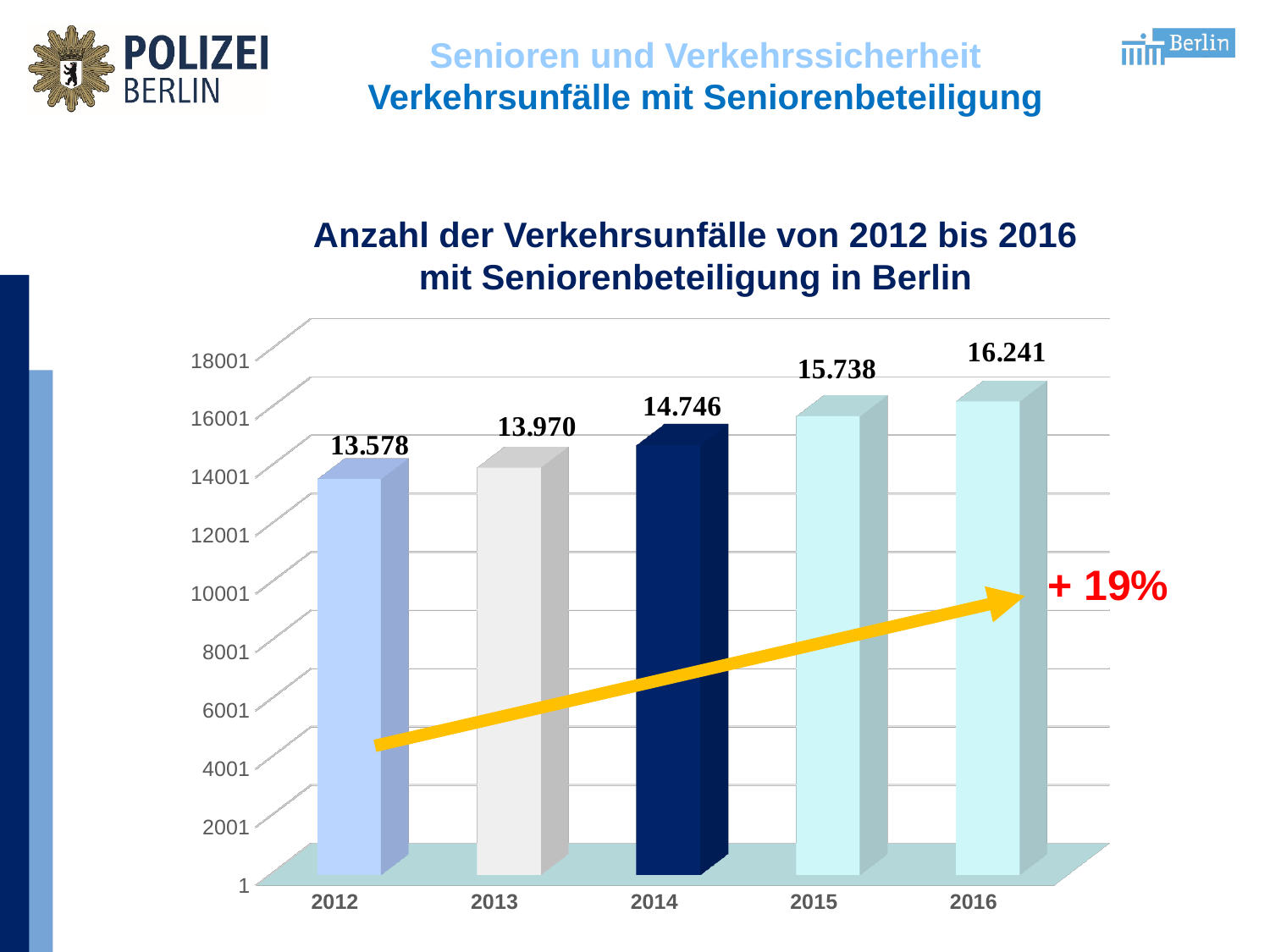
Do the values rise or fall from 2012 to 2016? rise What is the value for 2012? 13.578 Is the value for 2013 greater or less than 12001? greater What is the value for 2016? 16.241 Which year has the lowest value? 2012 What is the value for 2014? 14.746 Which is larger, the value for 2013 or the value for 2015? 2015 What kind of chart is shown? bar chart How many years are shown on the x axis? 5 What is the difference between the values for 2016 and 2012? 2.663 What is the difference between the values for 2015 and 2014? 992 Which year has the highest value? 2016